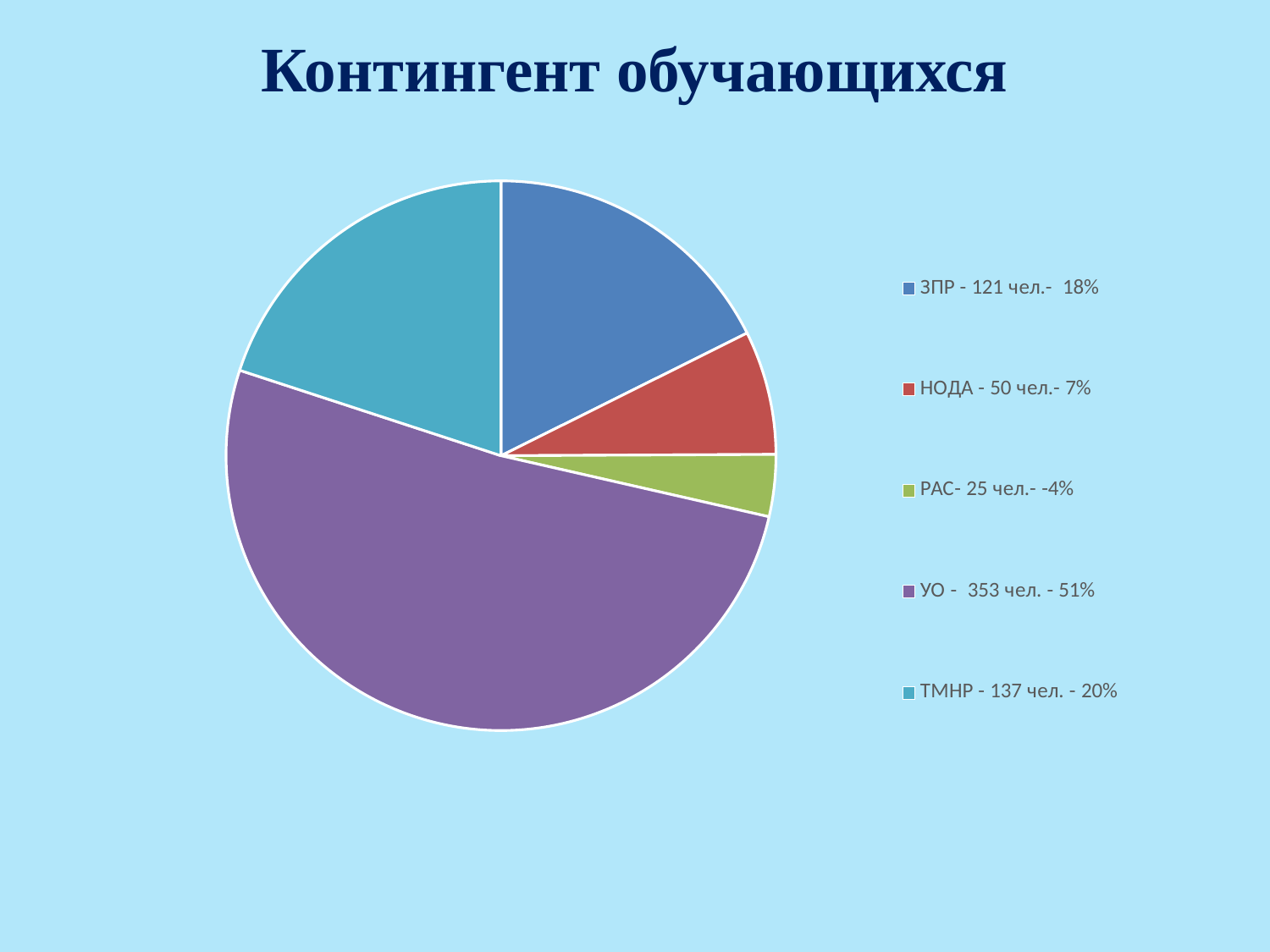
What is the difference in number of people between УО and ЗПР? 232 чел. How many categories does the pie chart have? 5 What colour is the slice for УО? purple How many people are in the ЗПР category? 121 чел. Which category has the largest slice of the pie? УО Which category has the smallest slice of the pie? РАС Which has more people, НОДА or ТМНР? ТМНР How many people are in the ТМНР category? 137 чел. What percentage share does УО have? 51% What percentage share does НОДА have? 7% What is the title of the chart? Контингент обучающихся What kind of chart is shown on the slide? pie chart